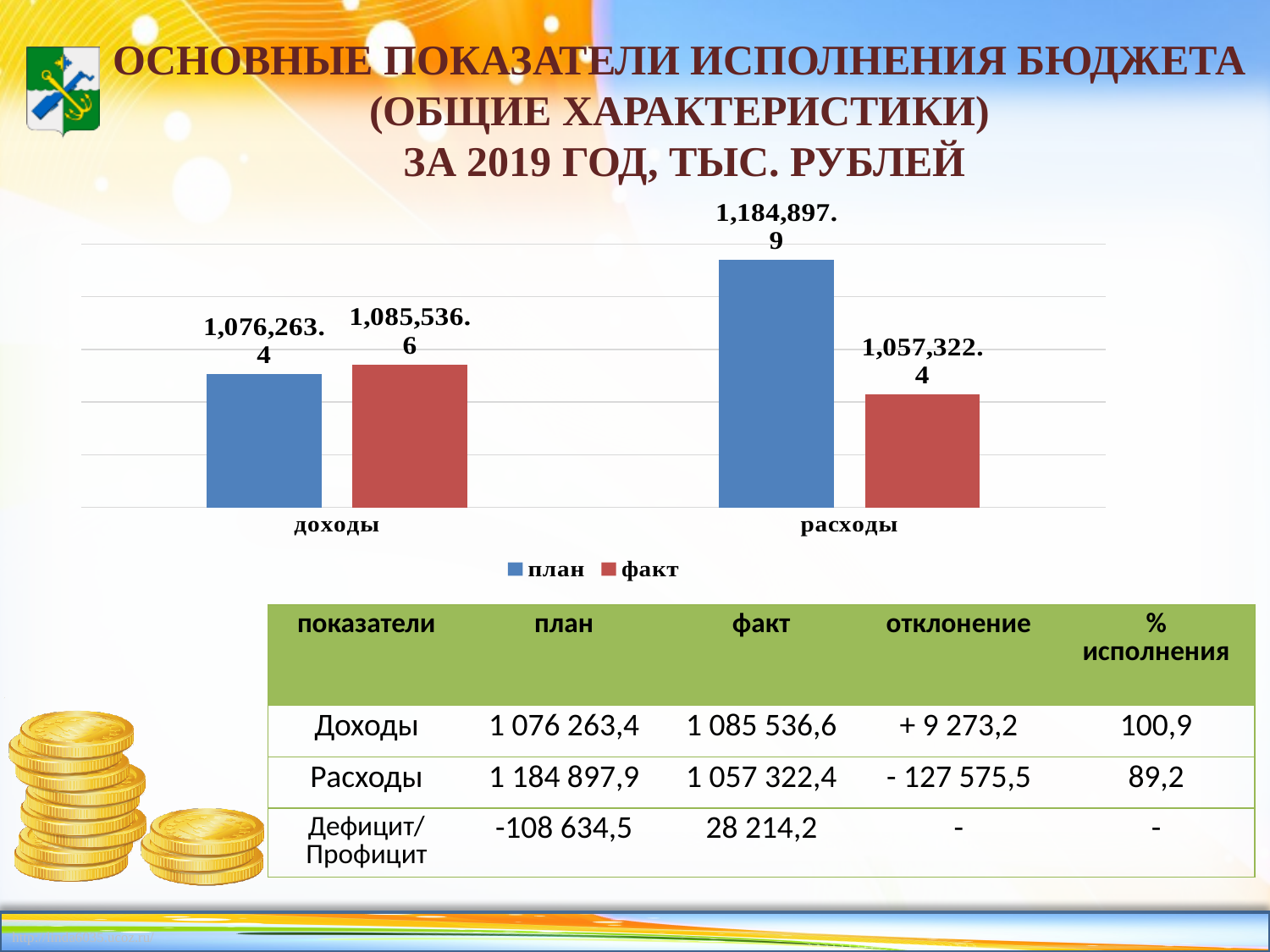
What is the факт value for расходы in the chart? 1,057,322.4 What is the план value for расходы in the chart? 1,184,897.9 For расходы, which is larger: план or факт? план How many series does the chart legend list? 2 Which bar in the chart has the highest value? план for расходы What is the difference between the план and факт values for расходы? 127,575.5 What is the difference between the факт and план values for доходы? 9,273.2 What is the факт value for доходы in the chart? 1,085,536.6 How many categories are shown on the x axis of the chart? 2 What kind of chart is shown on the slide? bar chart What is the план value for доходы in the chart? 1,076,263.4 Which bar in the chart has the lowest value? факт for расходы